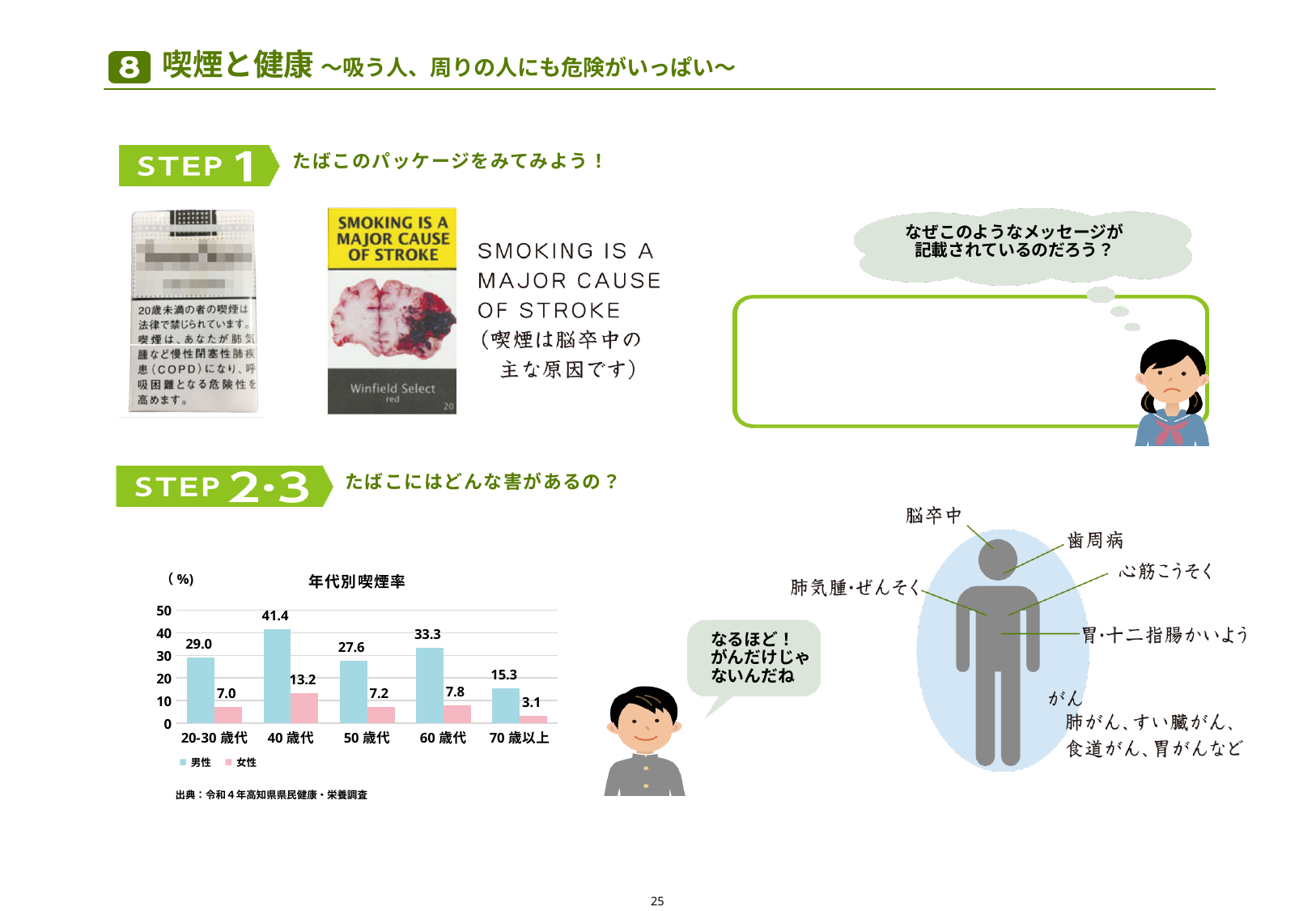
What is the smoking rate for 男性 in the 60歳代 group? 33.3 What is the smoking rate for 男性 in the 40歳代 group in the 年代別喫煙率 chart? 41.4 How many series does the legend of the 年代別喫煙率 chart list? 2 What is the unit shown on the y axis of the 年代別喫煙率 chart? % What is the difference between the 男性 and 女性 smoking rates in the 20-30歳代 group? 22.0 Which is larger, the 男性 smoking rate for 50歳代 or for 60歳代? 60歳代 Which age group has the highest smoking rate for 男性? 40歳代 Which age group has the lowest smoking rate for 女性? 70歳以上 How many age groups are shown in the 年代別喫煙率 chart? 5 What kind of chart is the 年代別喫煙率 chart? bar chart What is the smoking rate for 女性 in the 70歳以上 group? 3.1 Is the 男性 smoking rate for 40歳代 greater or less than 40? greater